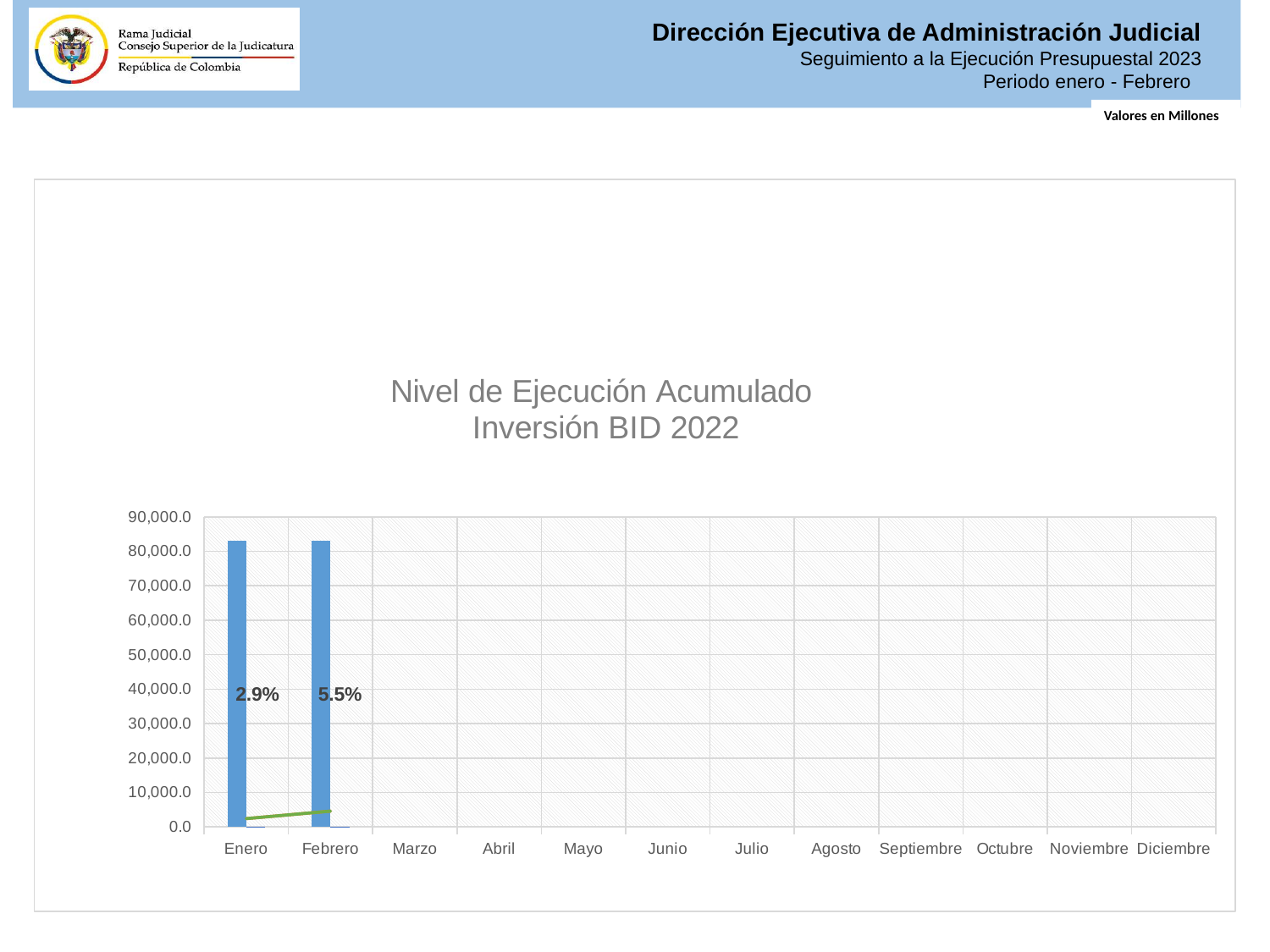
What percentage label is printed on the Enero bar? 2.9% Is the value of the Febrero bar greater or less than 90,000.0? less Which month has the higher percentage label, Enero or Febrero? Febrero How many months have a visible blue bar in the chart? 2 What is the highest value shown on the vertical axis of the chart? 90,000.0 What is the title of the chart? Nivel de Ejecución Acumulado Inversión BID 2022 Does the green line rise or fall from Enero to Febrero? rises How many month categories are shown on the x axis of the chart? 12 Is the value of the Enero bar greater or less than 80,000.0? greater What is the difference between the percentage labels for Febrero and Enero? 2.6% What percentage label is printed on the Febrero bar? 5.5% What kind of chart is shown on the slide? combination bar and line chart